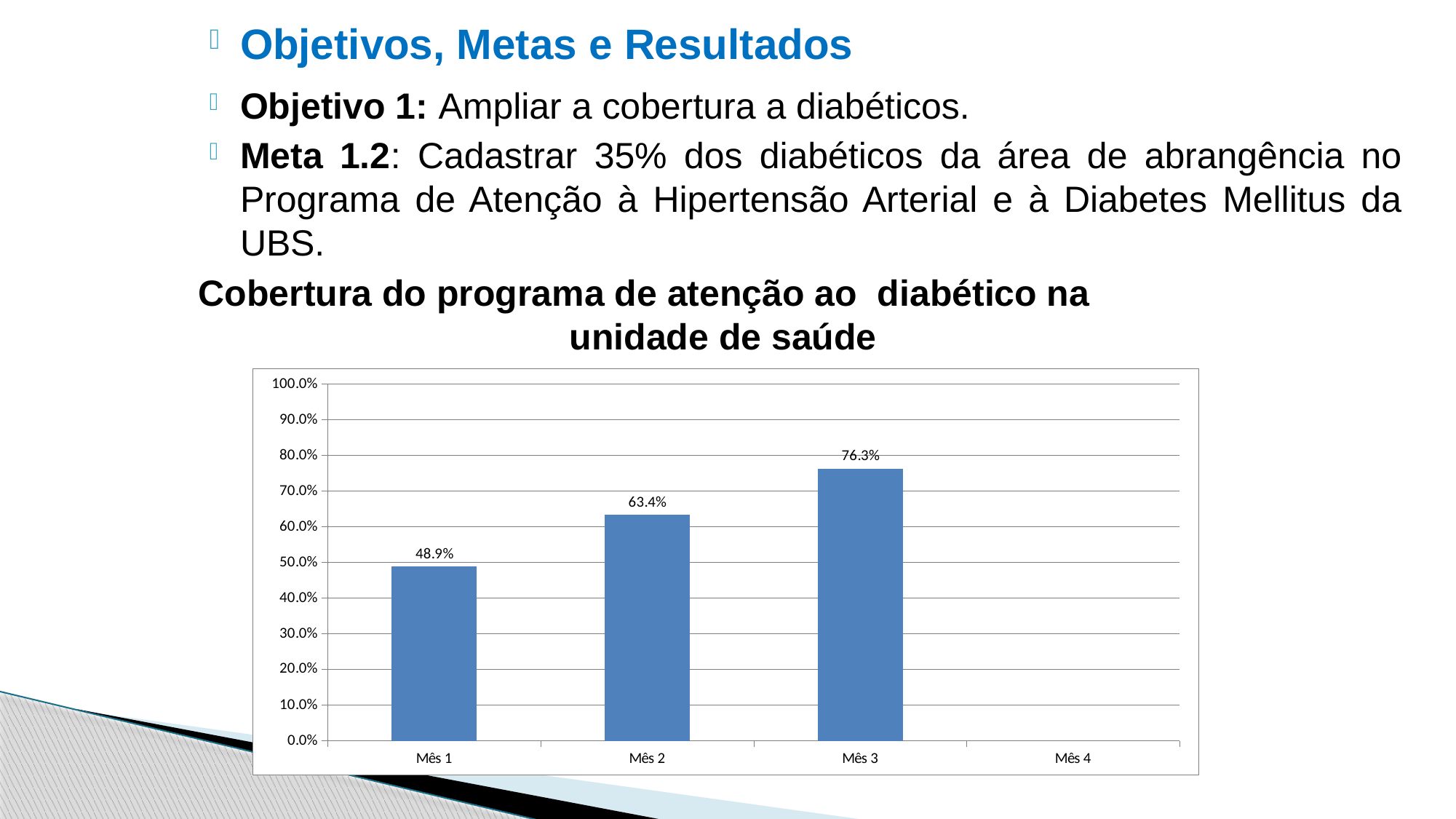
Do the values rise or fall from Mês 1 to Mês 3? Rise What is the difference between the values for Mês 3 and Mês 1? 27.4 percentage points Among the months with a plotted bar, which has the lowest value? Mês 1 What is the difference between the values for Mês 2 and Mês 1? 14.5 percentage points Which month has the highest coverage value? Mês 3 How many bars are plotted with a value in the chart? 3 Which is larger, the value for Mês 2 or the value for Mês 3? Mês 3 What is the value for Mês 3? 76.3% Is the value for Mês 2 greater or less than 60.0%? greater What is the value for Mês 2? 63.4% What is the value for Mês 1? 48.9% What kind of chart is shown on the slide? Bar chart